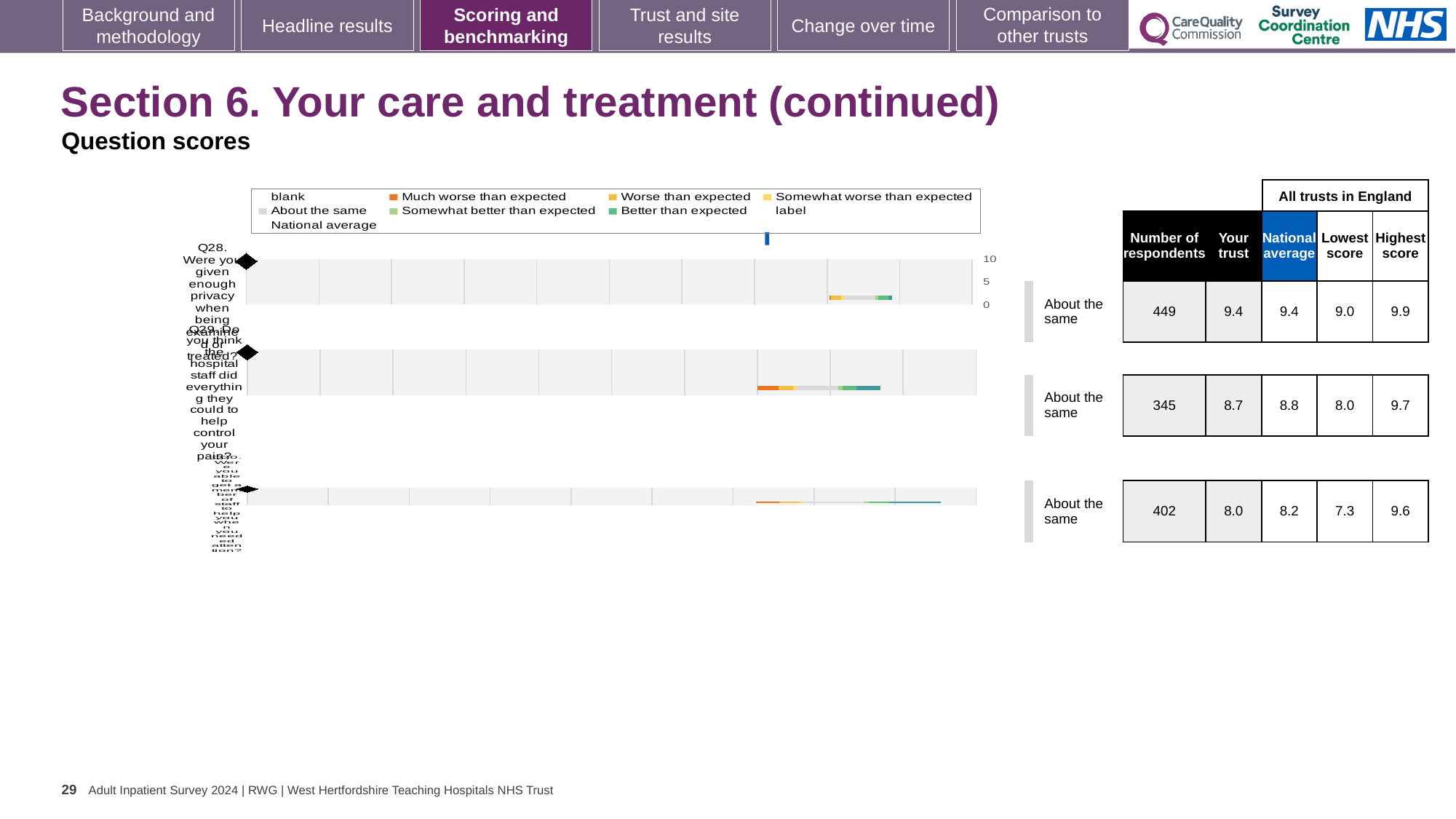
What is the difference between the highest score (9.9) and the lowest score (9.0) shown for Q28? 0.9 What is the national average score shown for Q29 (hospital staff helping control pain)? 8.8 What benchmark category is shown next to the Q29 chart? About the same Which of the three questions (Q28, Q29, Q30) has the lowest 'Your trust' score? Q30 For Q30, which is larger: the 'Your trust' score or the national average? National average What is the 'Your trust' score shown for Q28 (privacy when being examined or treated)? 9.4 Which of the three questions (Q28, Q29, Q30) has the highest 'Your trust' score? Q28 How many respondents are shown for Q30 (able to get a member of staff to help when needed)? 402 What is the highest score across all trusts in England shown for Q29? 9.7 What is the lowest score across all trusts in England shown for Q30? 7.3 How many questions are plotted on this slide? 3 What kind of chart is used to show the question scores on this slide? Bar chart